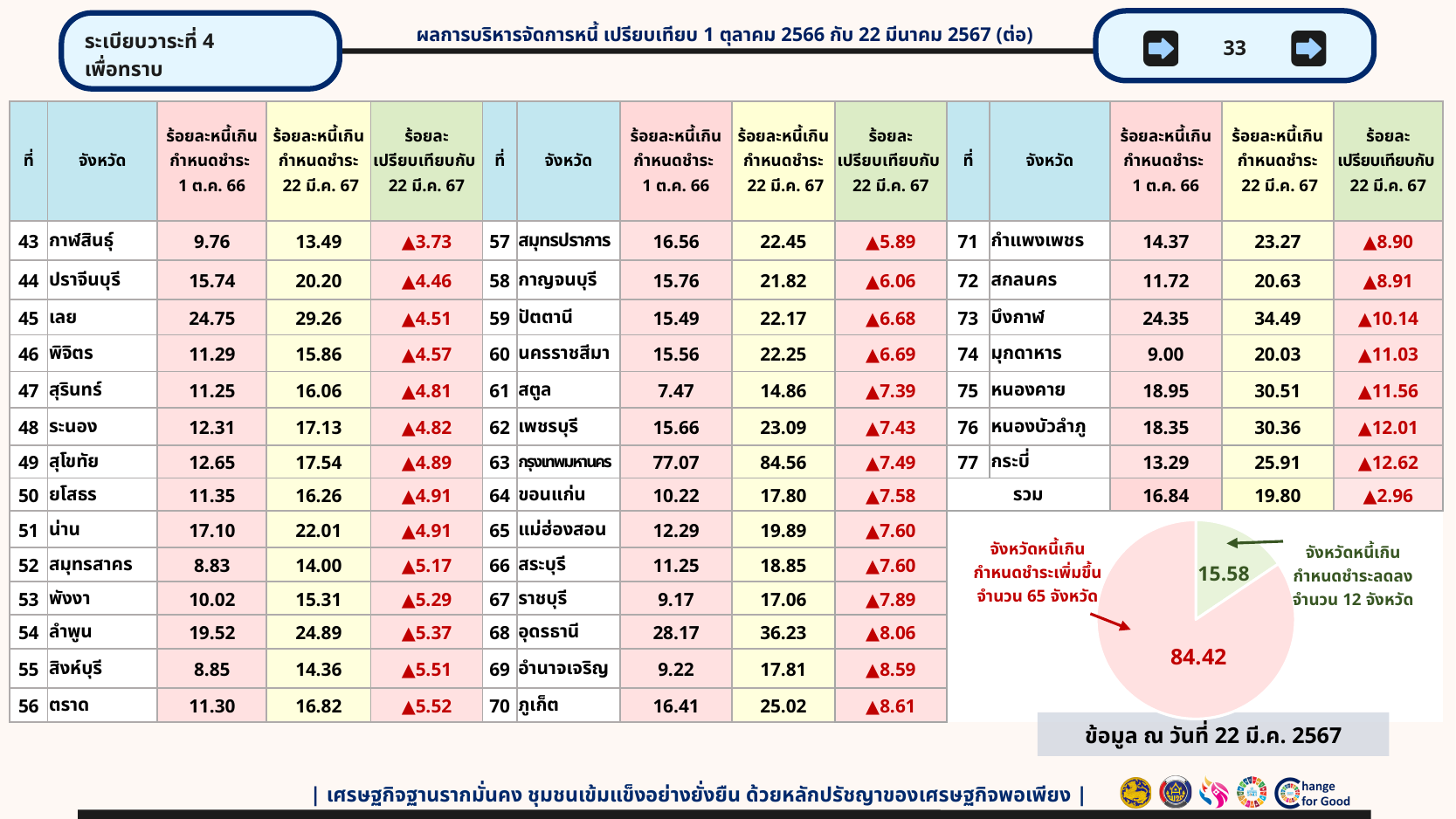
How many slices does the pie chart have? 2 In the pie chart, what value is shown for the slice labelled จังหวัดหนี้เกินกำหนดชำระลดลง? 15.58 In the pie chart, is the value for จังหวัดหนี้เกินกำหนดชำระลดลง larger or smaller than the value for จังหวัดหนี้เกินกำหนดชำระเพิ่มขึ้น? smaller What colour is the slice for จังหวัดหนี้เกินกำหนดชำระลดลง in the pie chart? green In the pie chart, what value is shown for the slice labelled จังหวัดหนี้เกินกำหนดชำระเพิ่มขึ้น? 84.42 What kind of chart is shown in the bottom right of the slide? pie chart In the pie chart, what is the difference between the value for จังหวัดหนี้เกินกำหนดชำระเพิ่มขึ้น and the value for จังหวัดหนี้เกินกำหนดชำระลดลง? 68.84 Which slice of the pie chart is the smallest? จังหวัดหนี้เกินกำหนดชำระลดลง According to the pie chart labels, how many provinces had an increase in overdue debt (จังหวัดหนี้เกินกำหนดชำระเพิ่มขึ้น)? 65 จังหวัด Which slice of the pie chart is the largest? จังหวัดหนี้เกินกำหนดชำระเพิ่มขึ้น What date is the data in the pie chart stated to be as of (ข้อมูล ณ วันที่)? 22 มี.ค. 2567 According to the pie chart labels, how many provinces had a decrease in overdue debt (จังหวัดหนี้เกินกำหนดชำระลดลง)? 12 จังหวัด